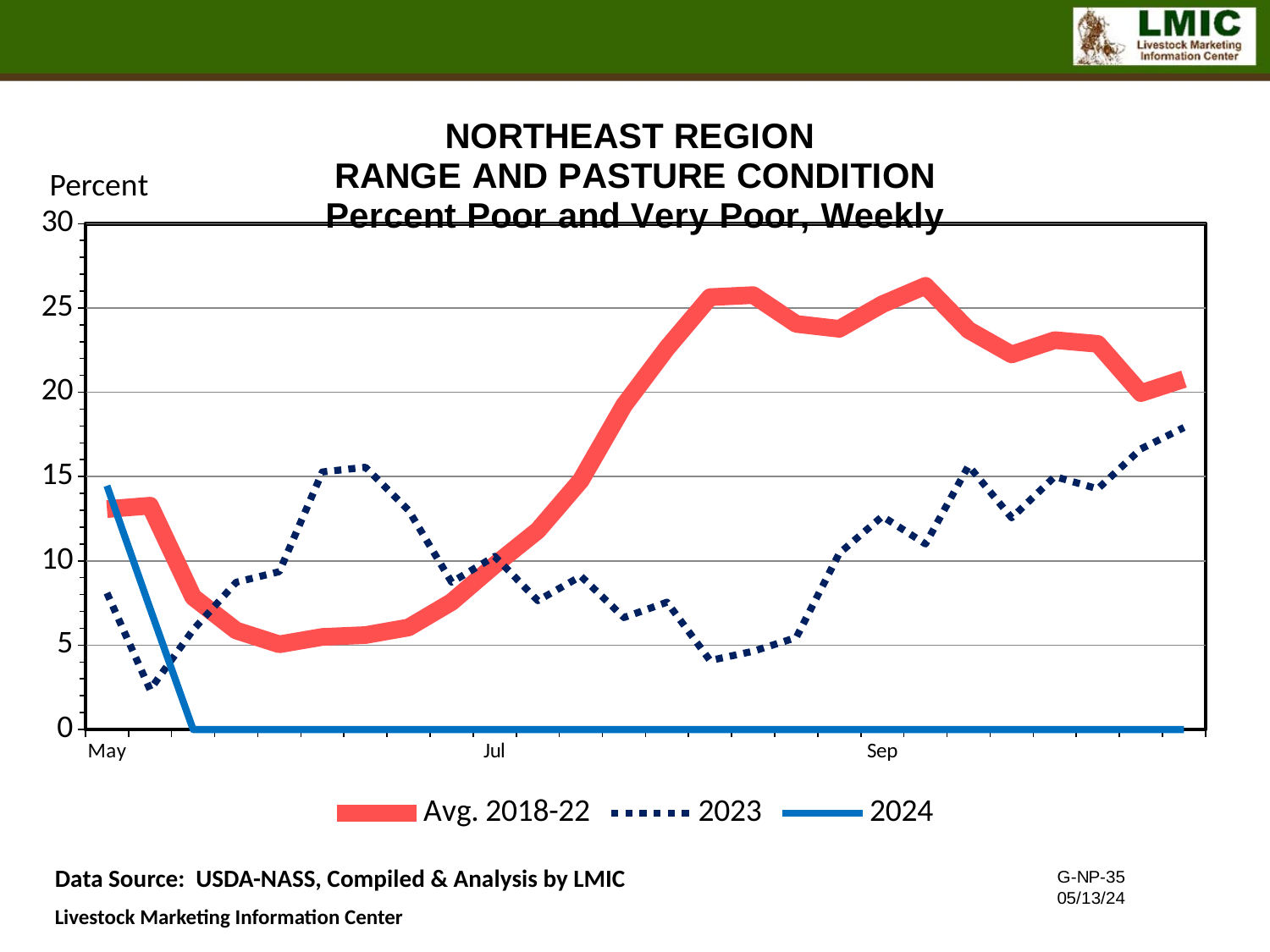
What is the label on the vertical axis of the chart? Percent Is the value for Avg. 2018-22 at the start of May greater or less than 10? greater Is the value for 2023 at the start of May greater or less than 10? less Is the highest value of the 2023 series greater or less than 15? greater What kind of chart is shown on the slide? line chart Does the 2024 series rise or fall from its first point in May? fall What are the three series listed in the legend? Avg. 2018-22, 2023, 2024 How many series does the legend list? 3 At Sep, which series has the higher value, Avg. 2018-22 or 2023? Avg. 2018-22 Which series reaches the highest value on the chart? Avg. 2018-22 Does the Avg. 2018-22 series rise or fall between Jul and Sep? rise